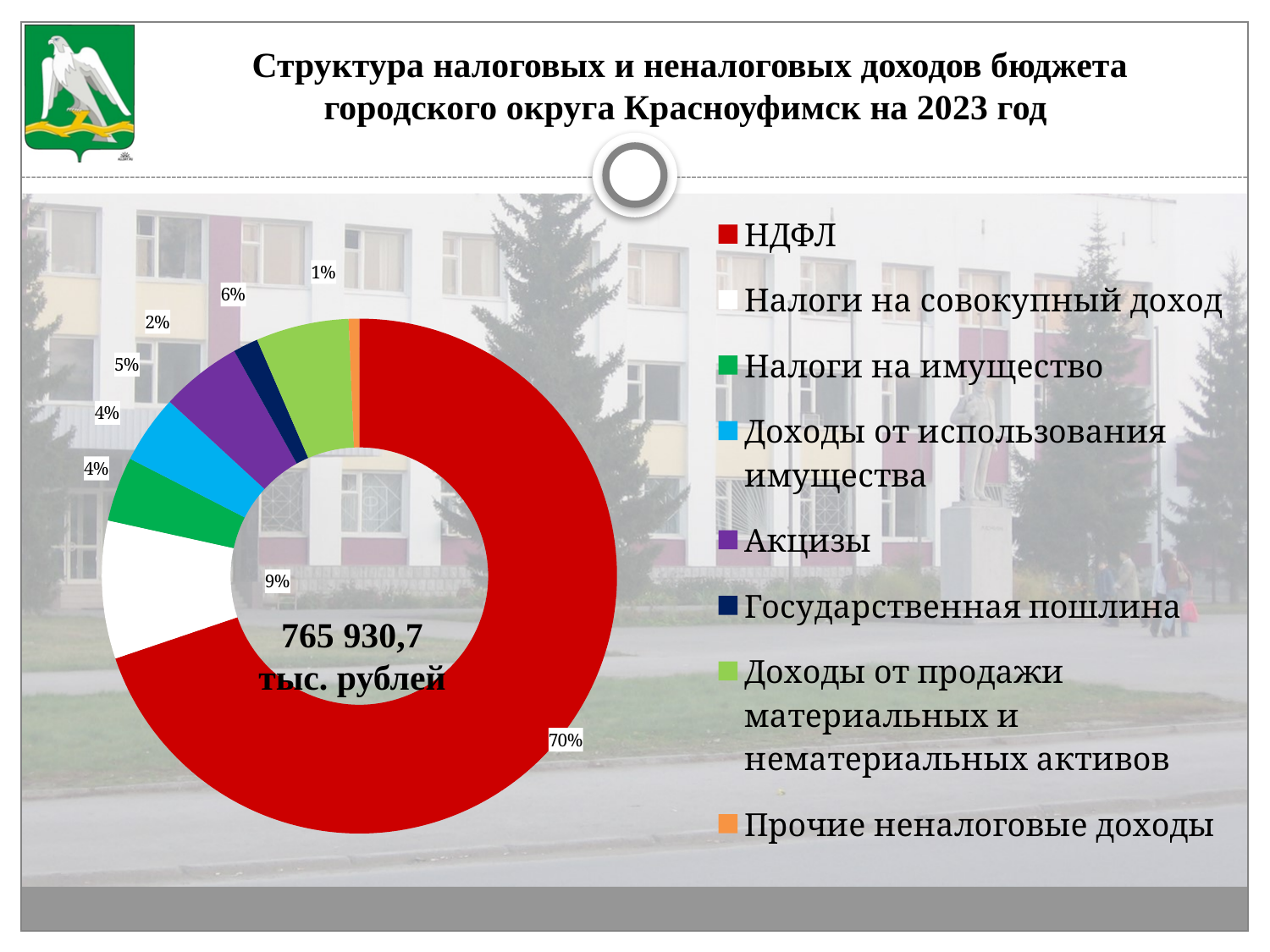
Which category has the largest share of the chart? НДФЛ By how many percentage points does the share of НДФЛ exceed the share of Налоги на совокупный доход? 61 percentage points What percentage is shown for Прочие неналоговые доходы? 1% Which has the larger share: Акцизы or Государственная пошлина? Акцизы What percentage is shown for Государственная пошлина? 2% Which category has the smallest share of the chart? Прочие неналоговые доходы What total amount is printed in the centre of the chart? 765 930,7 тыс. рублей What percentage is shown for Доходы от продажи материальных и нематериальных активов? 6% What share of the chart does НДФЛ account for? 70% What percentage is shown for Акцизы? 5% What percentage is shown for Налоги на совокупный доход? 9% How many categories does the legend list? 8